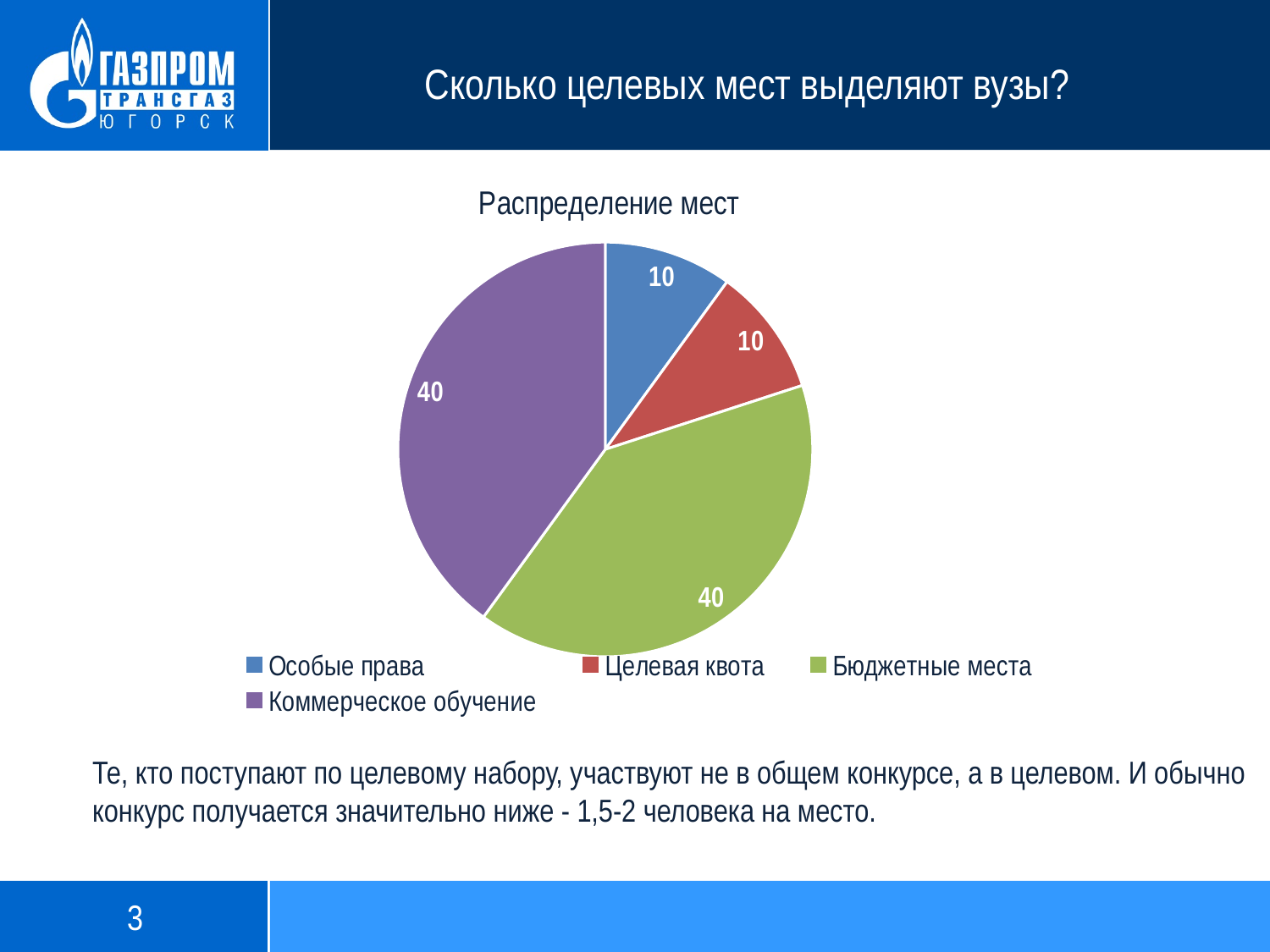
What is the value for Коммерческое обучение in the pie chart? 40 Which colour represents Коммерческое обучение in the pie chart? Purple What is the value for Целевая квота in the pie chart? 10 What is the title of the chart? Распределение мест What is the difference between the values for Коммерческое обучение and Особые права? 30 What is the value for Бюджетные места in the pie chart? 40 How many slices does the pie chart have? 4 What share of the pie does Целевая квота represent? 10% What is the value for Особые права in the pie chart? 10 What share of the pie does Бюджетные места represent? 40% Which is larger, Бюджетные места or Целевая квота? Бюджетные места What kind of chart is shown on the slide? Pie chart